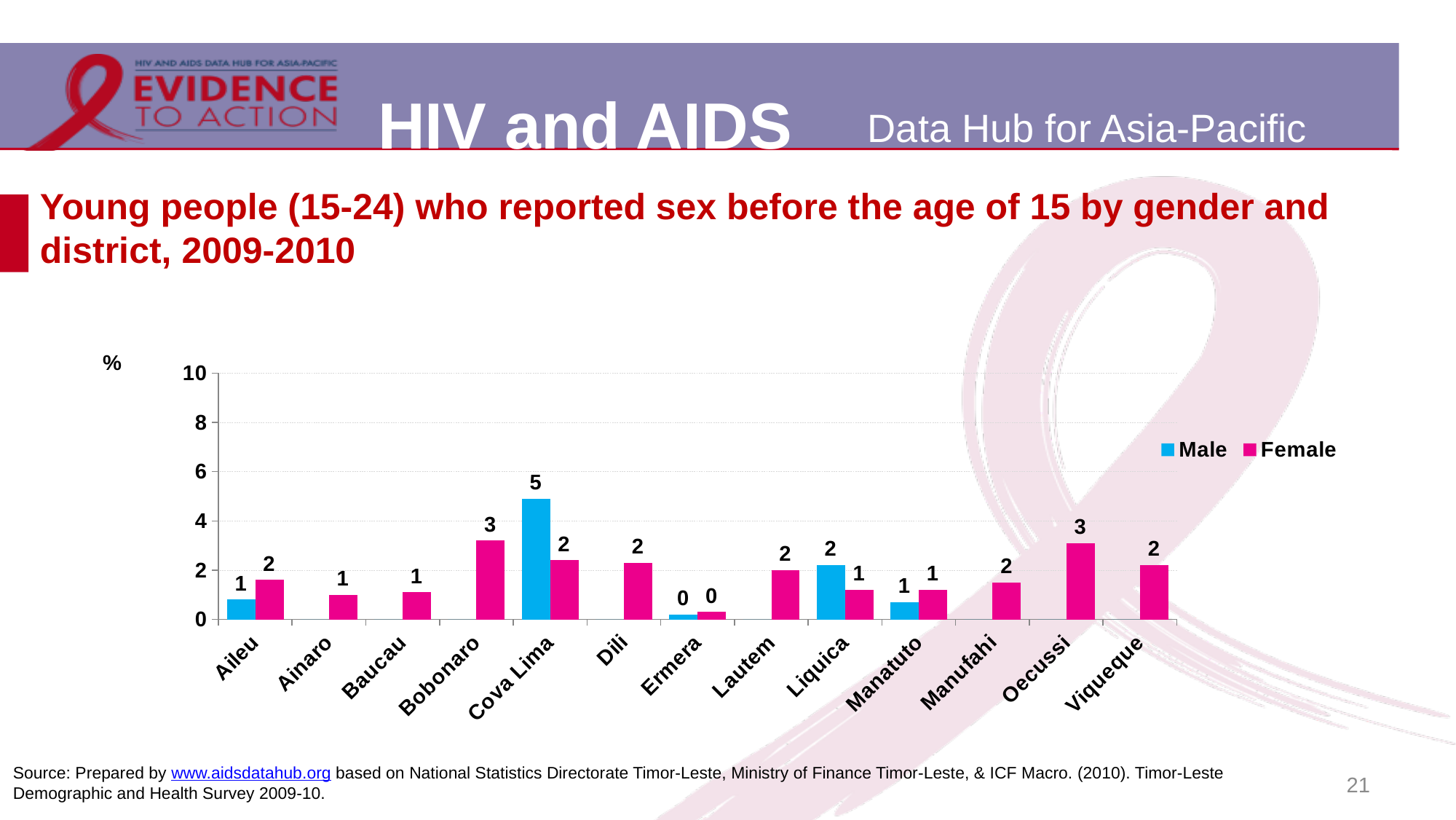
What kind of chart is shown on the slide? Bar chart What is the Female value for Bobonaro? 3 What is the Male value for Liquica? 2 How many series does the legend list? 2 What is the Female value for Oecussi? 3 Which is larger for Aileu, the Male value or the Female value? Female Which district has the lowest Female value? Ermera What is the Male value for Cova Lima? 5 Is the Male value for Cova Lima greater or less than 4? greater Which district has the highest Male value? Cova Lima How many districts are shown on the x axis? 13 What is the difference between the Male and Female values for Cova Lima? 3